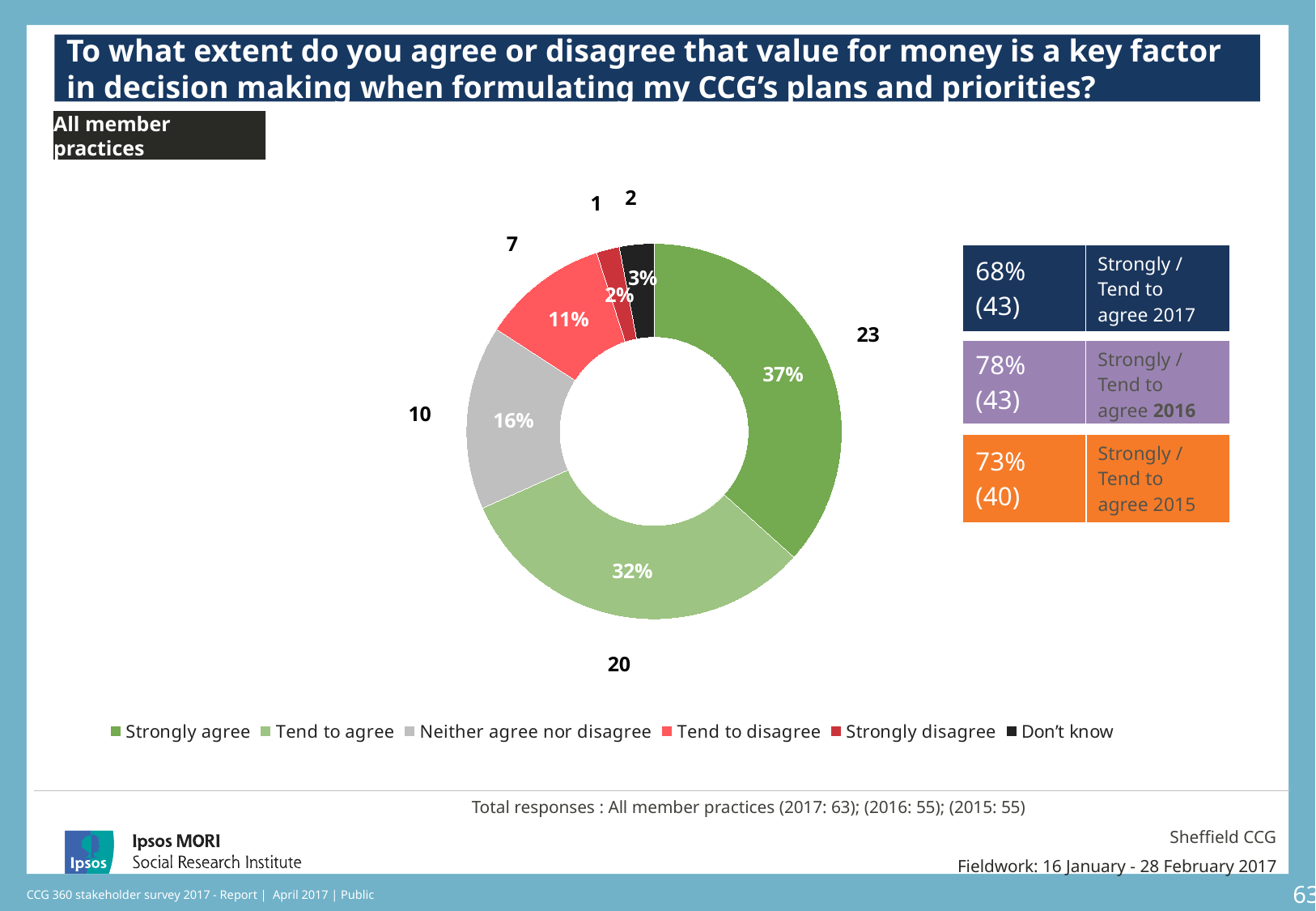
What is the combined percentage for Strongly agree and Tend to agree? 69% Which is larger, the share for Neither agree nor disagree or the share for Tend to disagree? Neither agree nor disagree How many response categories does the legend list? 6 What is the difference in percentage points between Strongly agree and Tend to agree? 5 Which response category has the smallest share of the chart? Strongly disagree What percentage of respondents neither agree nor disagree? 16% Which response category has the largest share of the chart? Strongly agree What colour represents Don't know in the chart? Black What percentage of respondents strongly agree? 37% How many respondents tend to disagree, according to the count label outside the chart? 7 What percentage of respondents tend to agree? 32% What kind of chart is shown on the slide? Donut (pie) chart